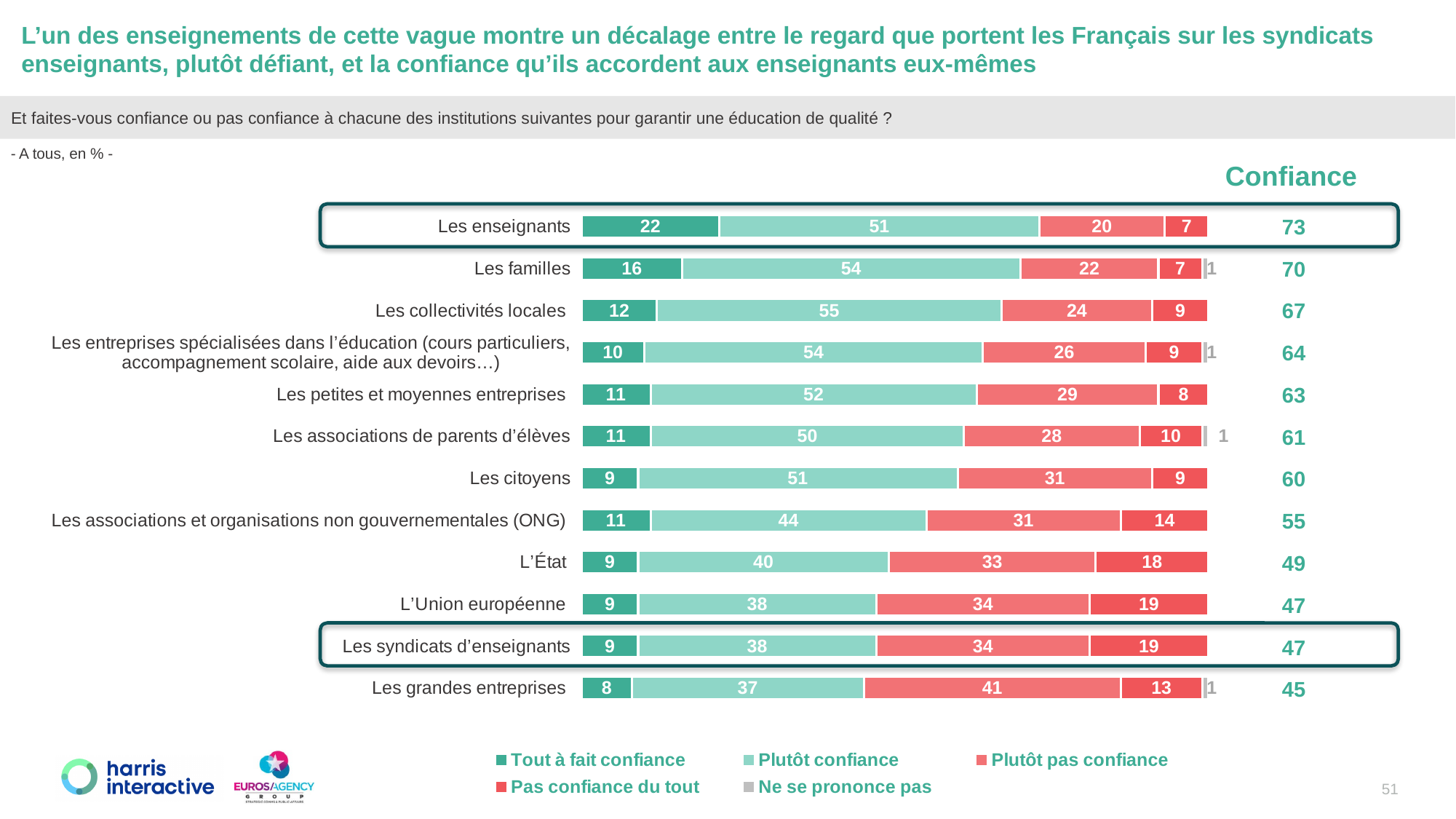
What is the total of the stacked bar for Les familles? 100 Which institution has the highest "Tout à fait confiance" value? Les enseignants How many institutions are listed in the chart? 12 What is the "Confiance" total shown for Les syndicats d'enseignants? 47 What is the difference between the "Confiance" total for Les enseignants and for Les syndicats d'enseignants? 26 What is the value of "Plutôt pas confiance" for Les grandes entreprises? 41 Which has the larger "Plutôt confiance" value, Les familles or Les citoyens? Les familles Which institution has the lowest "Confiance" total? Les grandes entreprises How many series does the legend list? 5 What kind of chart is shown on the slide? Stacked bar chart Which institution has the highest "Plutôt pas confiance" value? Les grandes entreprises What is the value of "Tout à fait confiance" for Les enseignants? 22